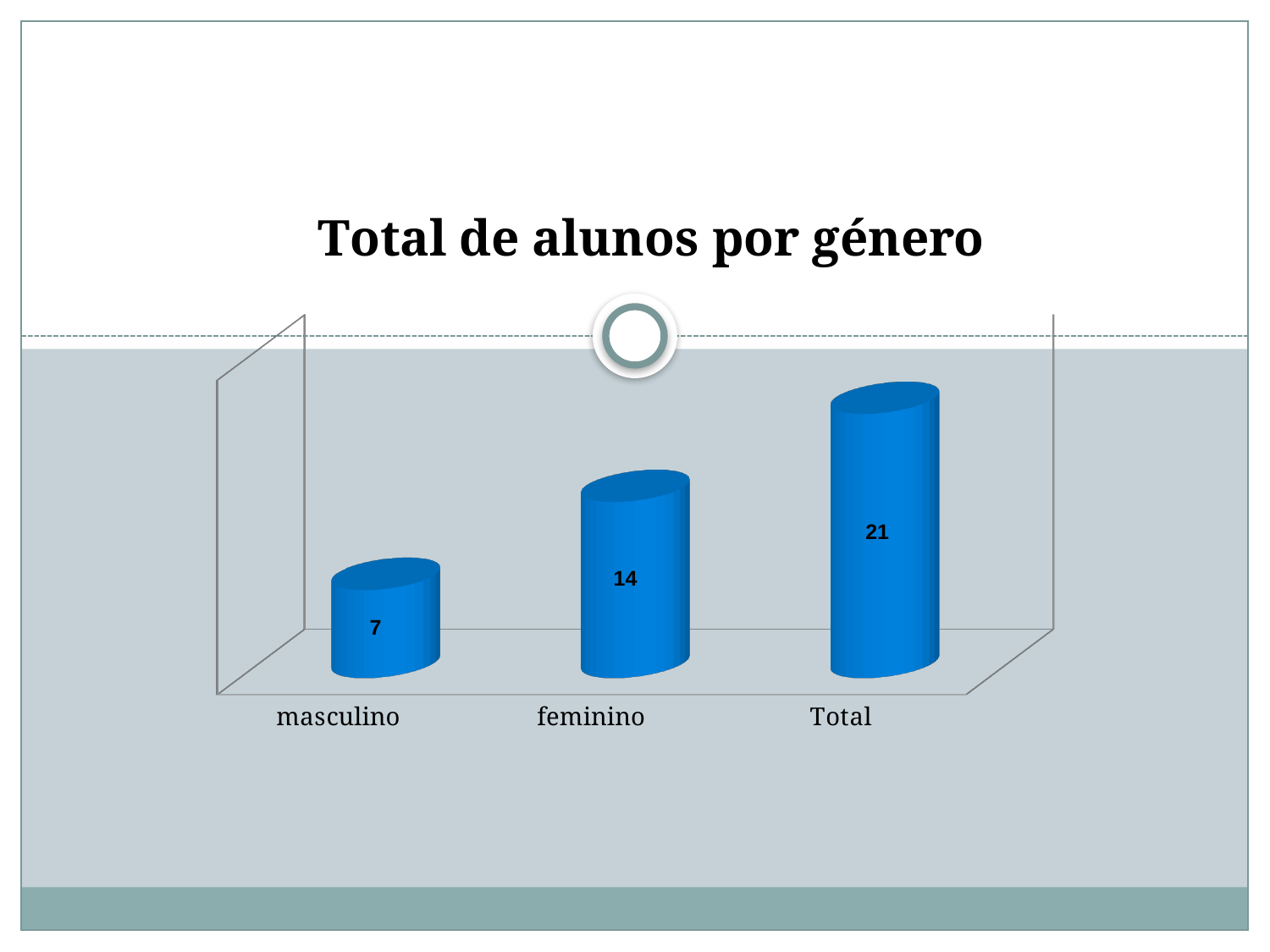
What is the value for Total? 21 What is the difference between the values for Total and feminino? 7 What is the title of the chart? Total de alunos por género Do the values rise or fall from left to right along the x axis? rise Which is larger, the value for feminino or the value for masculino? feminino What is the value for feminino? 14 What is the difference between the values for feminino and masculino? 7 What kind of chart is shown on the slide? bar chart What is the value for masculino? 7 How many categories are shown on the x axis? 3 Which category has the lowest value? masculino Which category has the highest value? Total